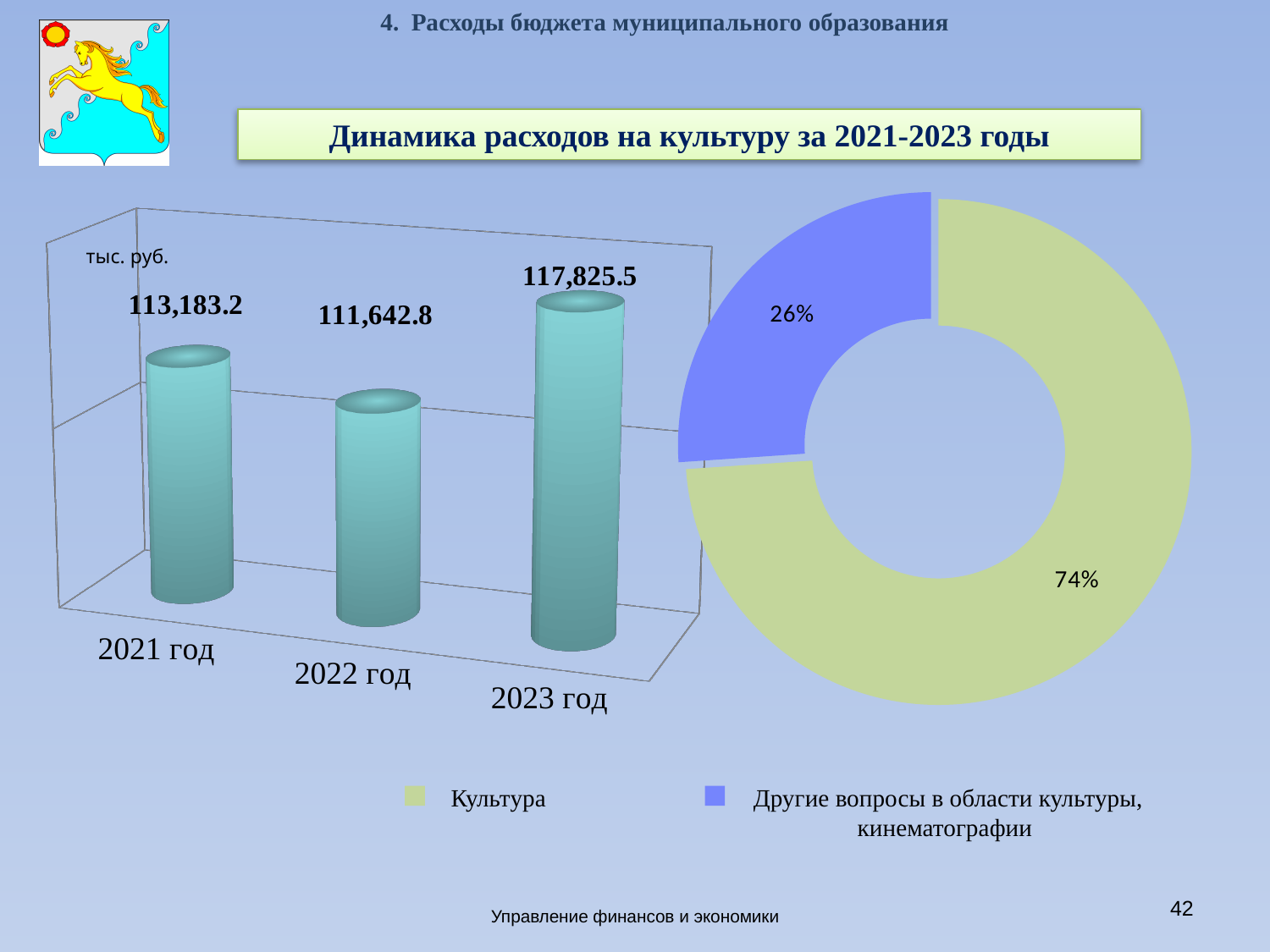
On the bar chart on the left, which is larger: the value for 2021 год or 2022 год? 2021 год On the bar chart on the left, what is the difference between the values for 2023 год and 2021 год? 4,642.3 On the bar chart on the left, what is the difference between the values for 2021 год and 2022 год? 1,540.4 On the bar chart on the left, which year has the highest value? 2023 год On the bar chart on the left, which year has the lowest value? 2022 год On the doughnut chart on the right, what share does Культура have? 74% On the bar chart on the left, what is the value for 2021 год? 113,183.2 What kind of chart is shown on the left of the slide? Bar chart On the bar chart on the left, what is the value for 2022 год? 111,642.8 On the bar chart on the left, what is the value for 2023 год? 117,825.5 On the doughnut chart on the right, what share does Другие вопросы в области культуры, кинематографии have? 26% How many bars are shown on the bar chart on the left? 3